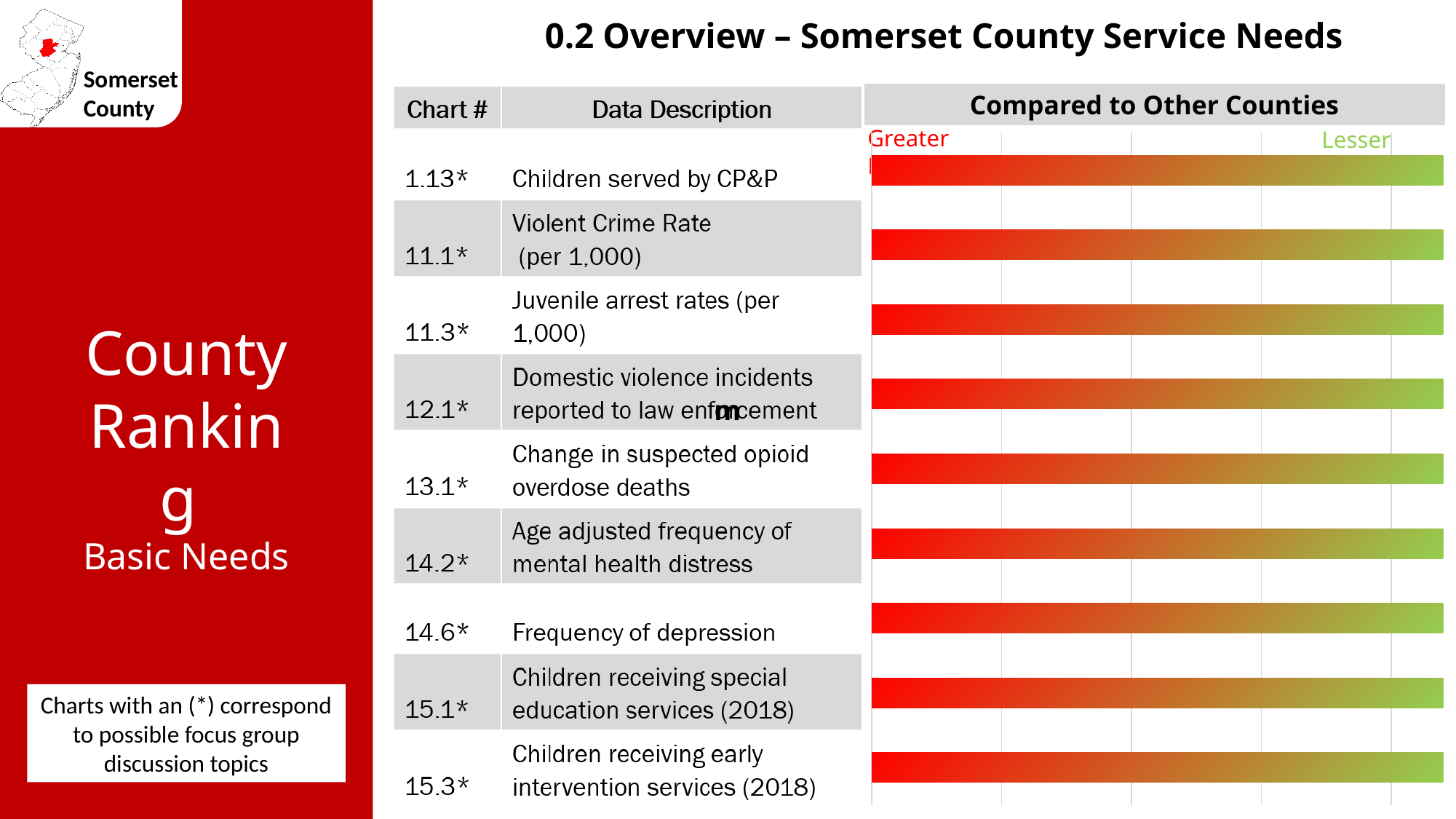
How many bars are plotted in the "Compared to Other Counties" chart? 9 What label appears at the left end of the chart's scale? Greater How many data descriptions are listed in the table next to the chart? 9 Which chart number corresponds to "Violent Crime Rate (per 1,000)"? 11.1* What is the title of the chart on the right side of the slide? Compared to Other Counties What kind of chart is shown under "Compared to Other Counties"? bar chart Which data description corresponds to chart number 14.6*? Frequency of depression